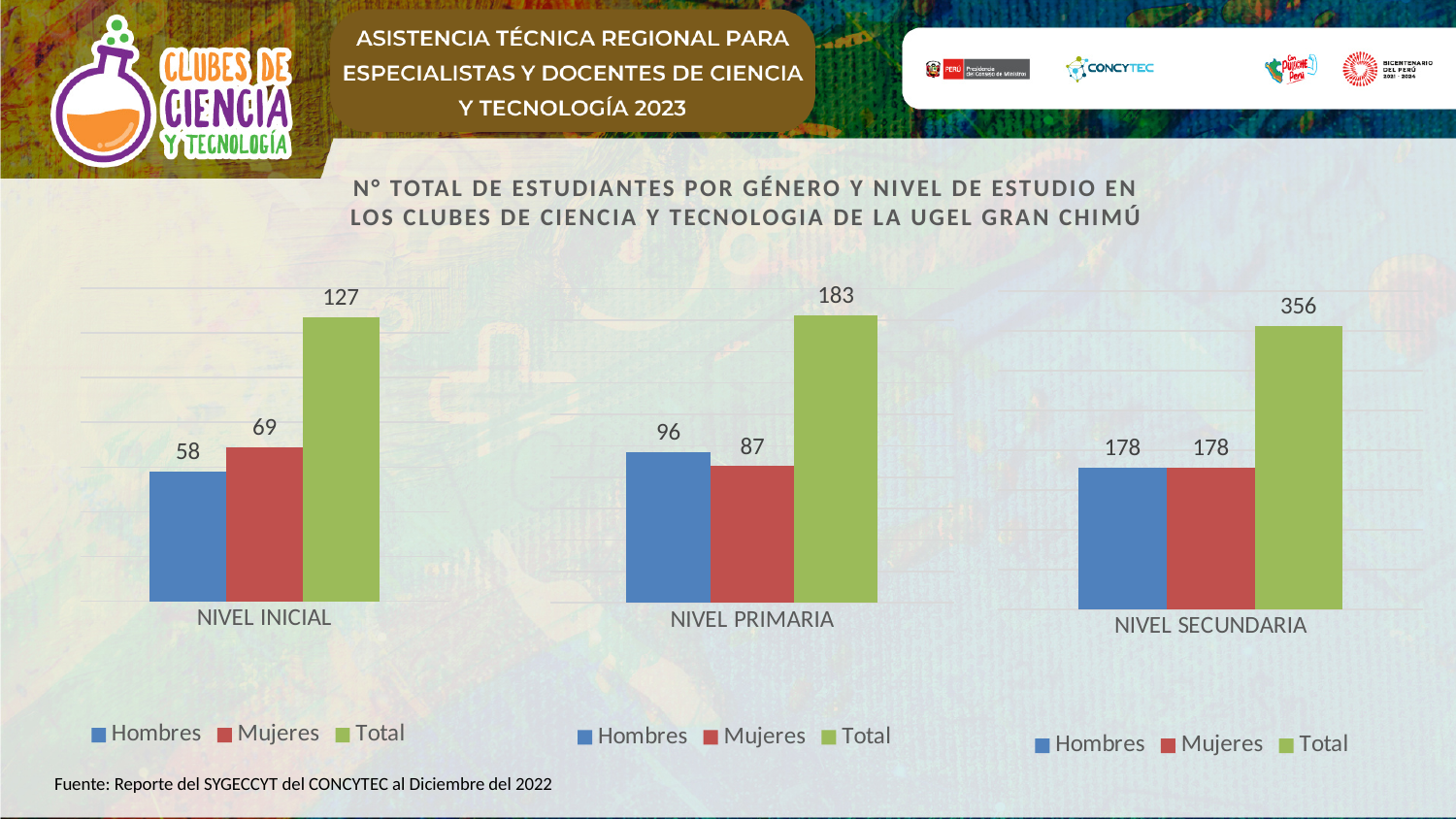
In the NIVEL INICIAL chart, what is the value for Mujeres? 69 In the NIVEL INICIAL chart, what is the value for Hombres? 58 How many series does the legend of the NIVEL SECUNDARIA chart list? 3 In the NIVEL INICIAL chart, what is the difference between the Mujeres and Hombres values? 11 In the NIVEL SECUNDARIA chart, what colour is the Total bar? Green In the NIVEL SECUNDARIA chart, what is the value for Hombres? 178 In the NIVEL PRIMARIA chart, what is the value for Total? 183 In the NIVEL PRIMARIA chart, which series has the lowest value? Mujeres What kind of chart is the NIVEL INICIAL chart? Bar chart In the NIVEL PRIMARIA chart, what is the difference between the Total and Hombres values? 87 In the NIVEL PRIMARIA chart, which is larger, Hombres or Mujeres? Hombres In the NIVEL SECUNDARIA chart, which series has the highest value? Total